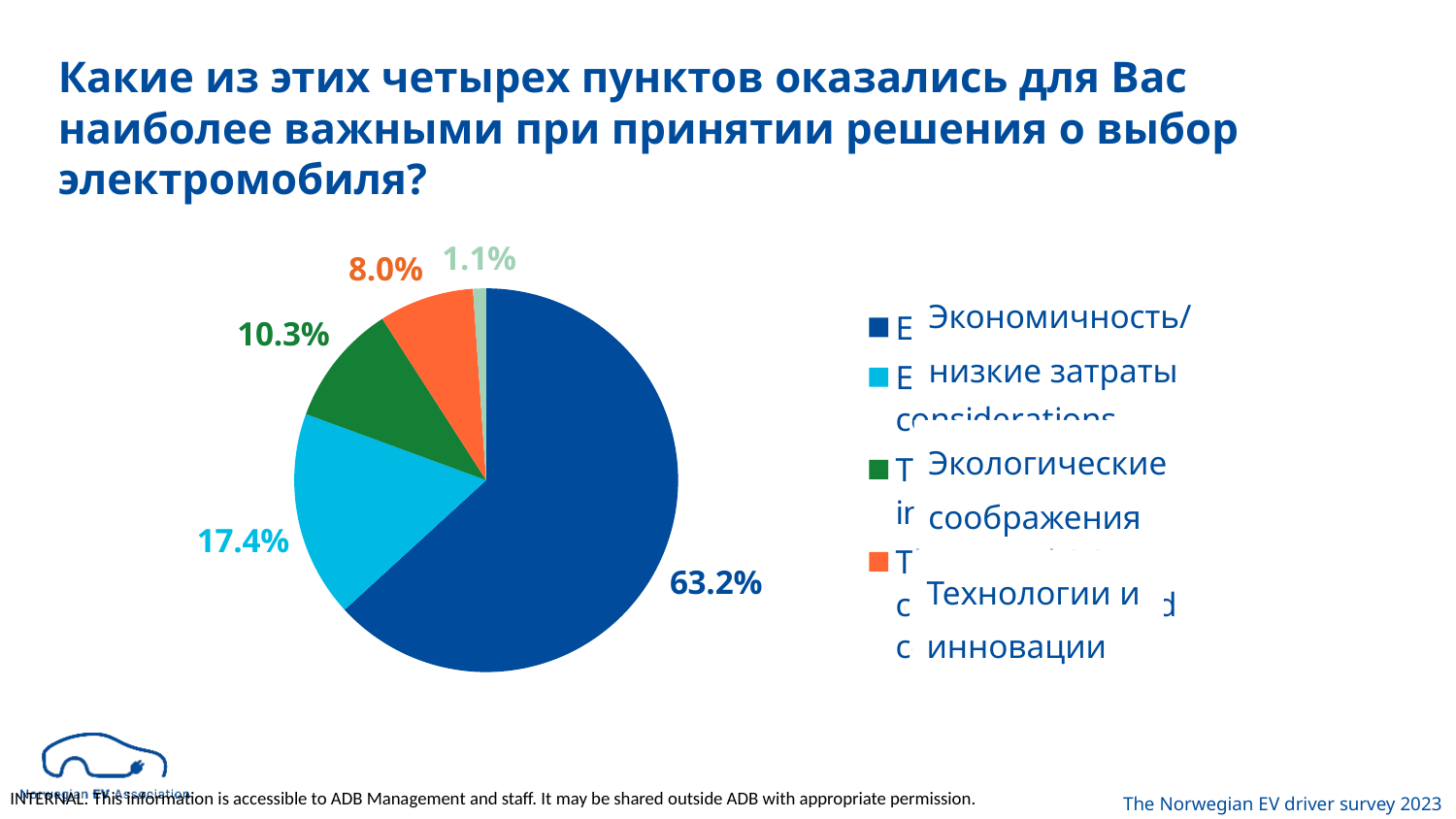
What is the difference in percentage points between the largest slice (63.2%) and the light blue slice (17.4%)? 45.8 Which slice is larger: the green slice or the orange slice? the green slice (10.3%) How many slices does the pie chart have? 5 What percentage is shown for the green slice of the pie chart? 10.3% What is the combined share of the green and orange slices? 18.3% What percentage is shown for the light blue slice of the pie chart? 17.4% What percentage is shown for the orange slice of the pie chart? 8.0% Is the dark blue slice greater or less than half of the pie? greater What is the value of the largest slice of the pie chart? 63.2% What kind of chart is shown on the slide? pie chart What is the value of the smallest slice of the pie chart? 1.1% What survey is cited as the source at the bottom right of the slide? The Norwegian EV driver survey 2023